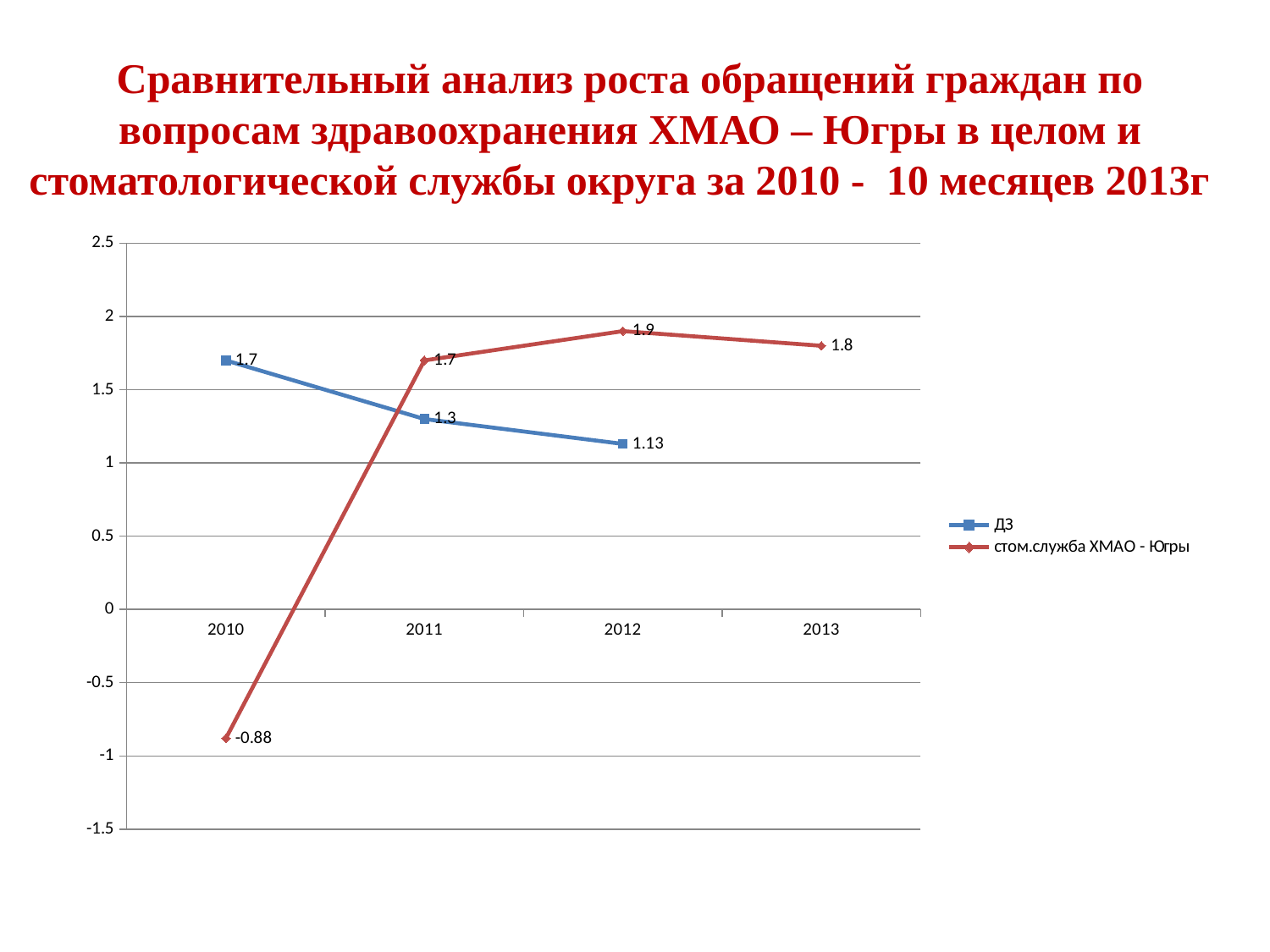
What kind of chart is shown on the slide? line chart What is the value for ДЗ in 2010? 1.7 Does the ДЗ series rise or fall from 2010 to 2012? fall What is the value for стом.служба ХМАО - Югры in 2010? -0.88 How many years are shown on the x axis? 4 In which year is the value for ДЗ lowest? 2012 What is the value for ДЗ in 2012? 1.13 Which series has the larger value in 2011, ДЗ or стом.служба ХМАО - Югры? стом.служба ХМАО - Югры What is the value for стом.служба ХМАО - Югры in 2013? 1.8 In which year does стом.служба ХМАО - Югры reach its highest value? 2012 How many series does the legend list? 2 What is the difference between the стом.служба ХМАО - Югры value and the ДЗ value in 2012? 0.77